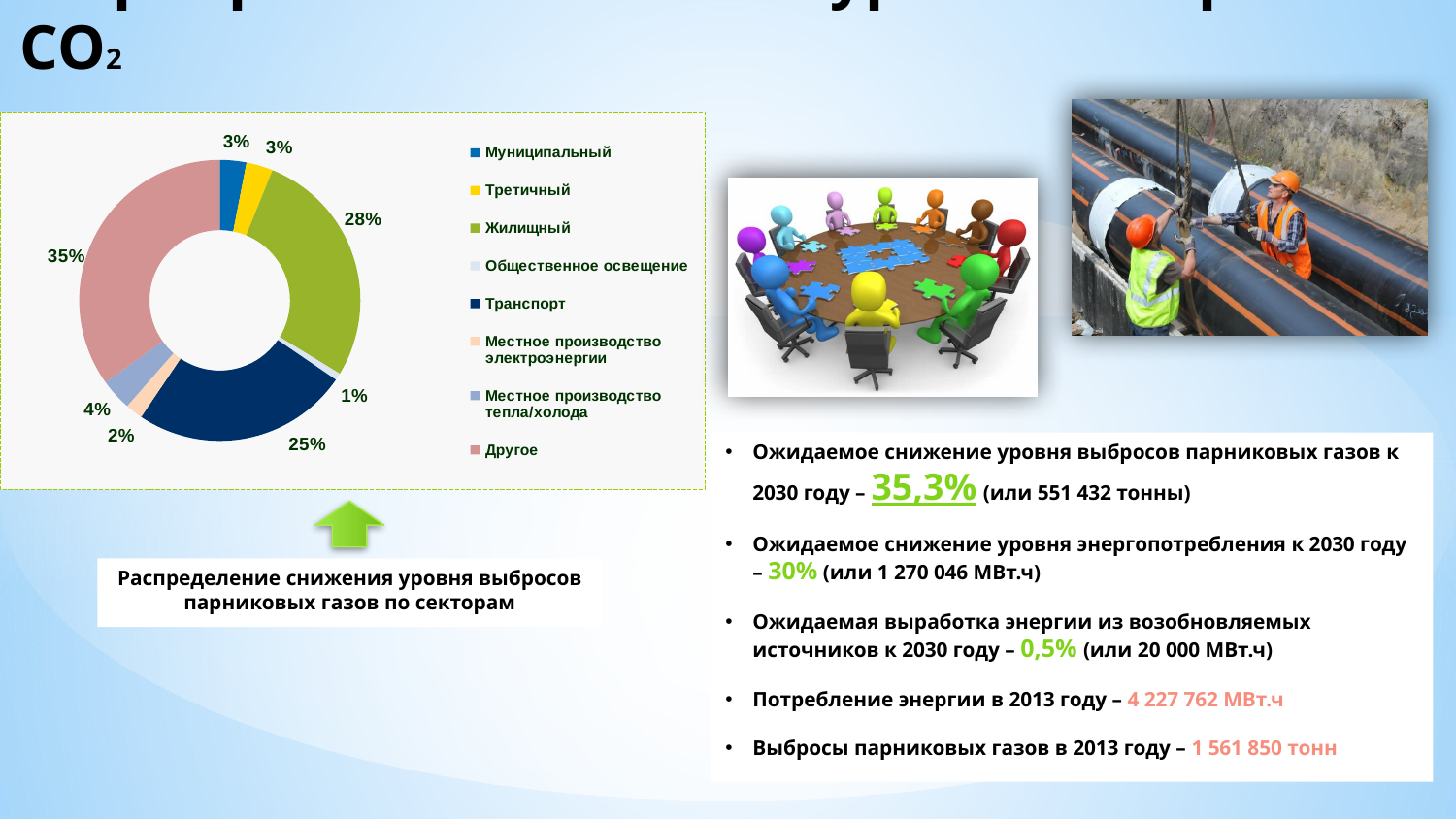
What percentage is shown for Другое? 35% Which is larger, the share for Жилищный or the share for Транспорт? Жилищный Which sector has the smallest share in the chart? Общественное освещение What share of the chart does the Жилищный sector account for? 28% What is the difference in percentage points between Другое and Транспорт? 10 How many sectors are listed in the chart legend? 8 What colour represents Жилищный in the chart? Green What is the value shown for Транспорт in the chart? 25% What type of chart is shown on the slide? Doughnut (pie) chart Which sector has the largest share in the chart? Другое What value does the chart show for Общественное освещение? 1% What is the value for Местное производство тепла/холода? 4%